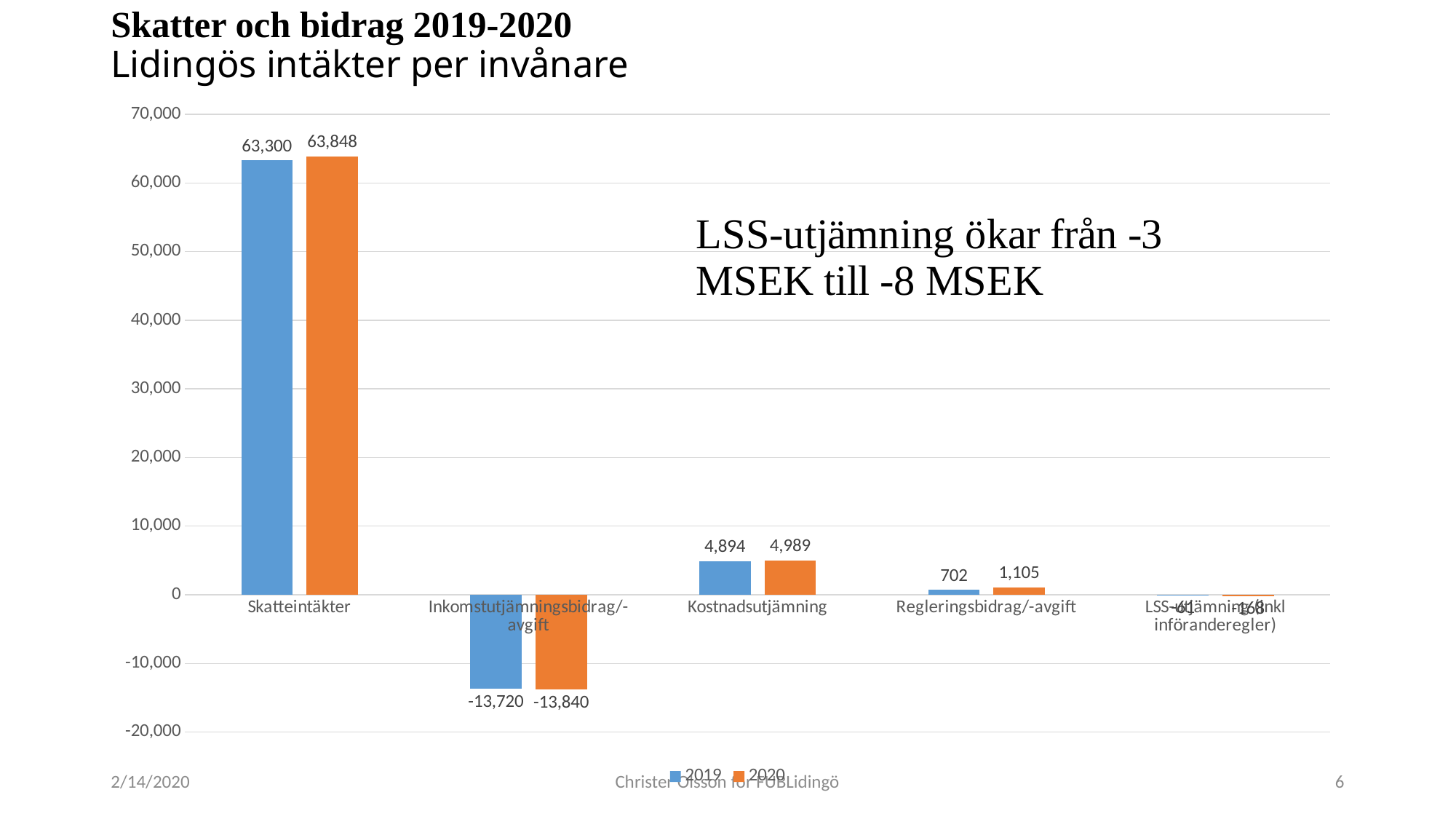
How many categories are shown on the x axis? 5 Which category has the lowest value in 2019? Inkomstutjämningsbidrag/-avgift Which is larger for Regleringsbidrag/-avgift, the 2019 value or the 2020 value? 2020 What is the value for Skatteintäkter in 2020? 63,848 What is the value for Regleringsbidrag/-avgift in 2020? 1,105 What is the difference between the 2020 and 2019 values for Skatteintäkter? 548 What is the value for Kostnadsutjämning in 2019? 4,894 What is the value for Skatteintäkter in 2019? 63,300 What is the value for Inkomstutjämningsbidrag/-avgift in 2020? -13,840 What kind of chart is shown on the slide? Bar chart Which category has the highest value in 2020? Skatteintäkter How many series does the legend list? 2